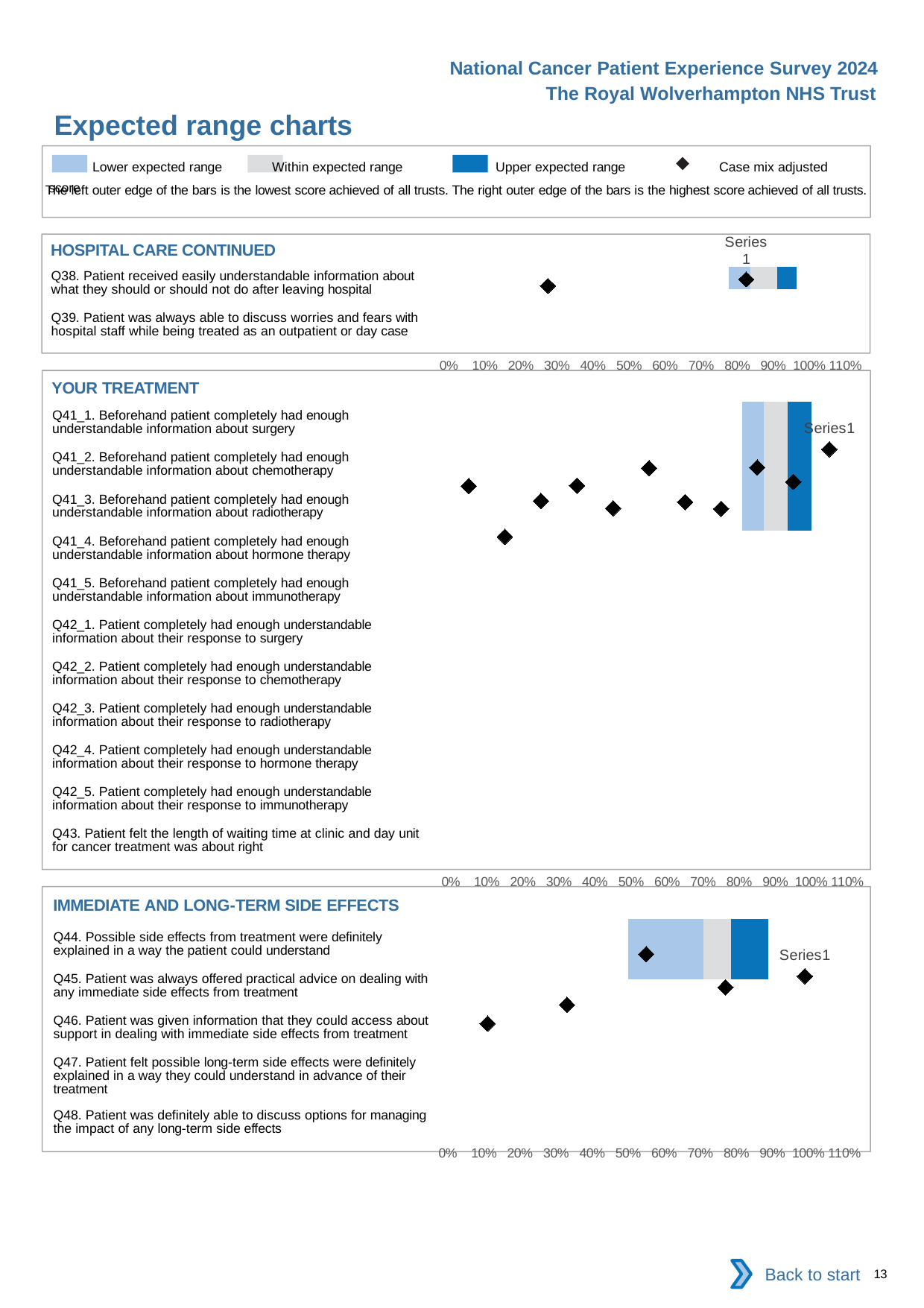
In the 'YOUR TREATMENT' chart, is the lowest case mix adjusted score marker greater or less than 20%? less What kind of chart is used in the 'YOUR TREATMENT' section? Bar chart How many entries does the legend at the top of the slide list? 4 How many questions are listed in the 'IMMEDIATE AND LONG-TERM SIDE EFFECTS' chart? 5 How many questions are listed in the 'YOUR TREATMENT' chart? 11 In the 'YOUR TREATMENT' chart, is the highest case mix adjusted score marker greater or less than 90%? greater Which legend entry is shown in dark blue? Upper expected range How many questions are listed in the 'HOSPITAL CARE CONTINUED' chart? 2 In the 'IMMEDIATE AND LONG-TERM SIDE EFFECTS' chart, is the highest case mix adjusted score marker greater or less than 90%? greater What is the highest tick label shown on the x axis of the charts? 110%